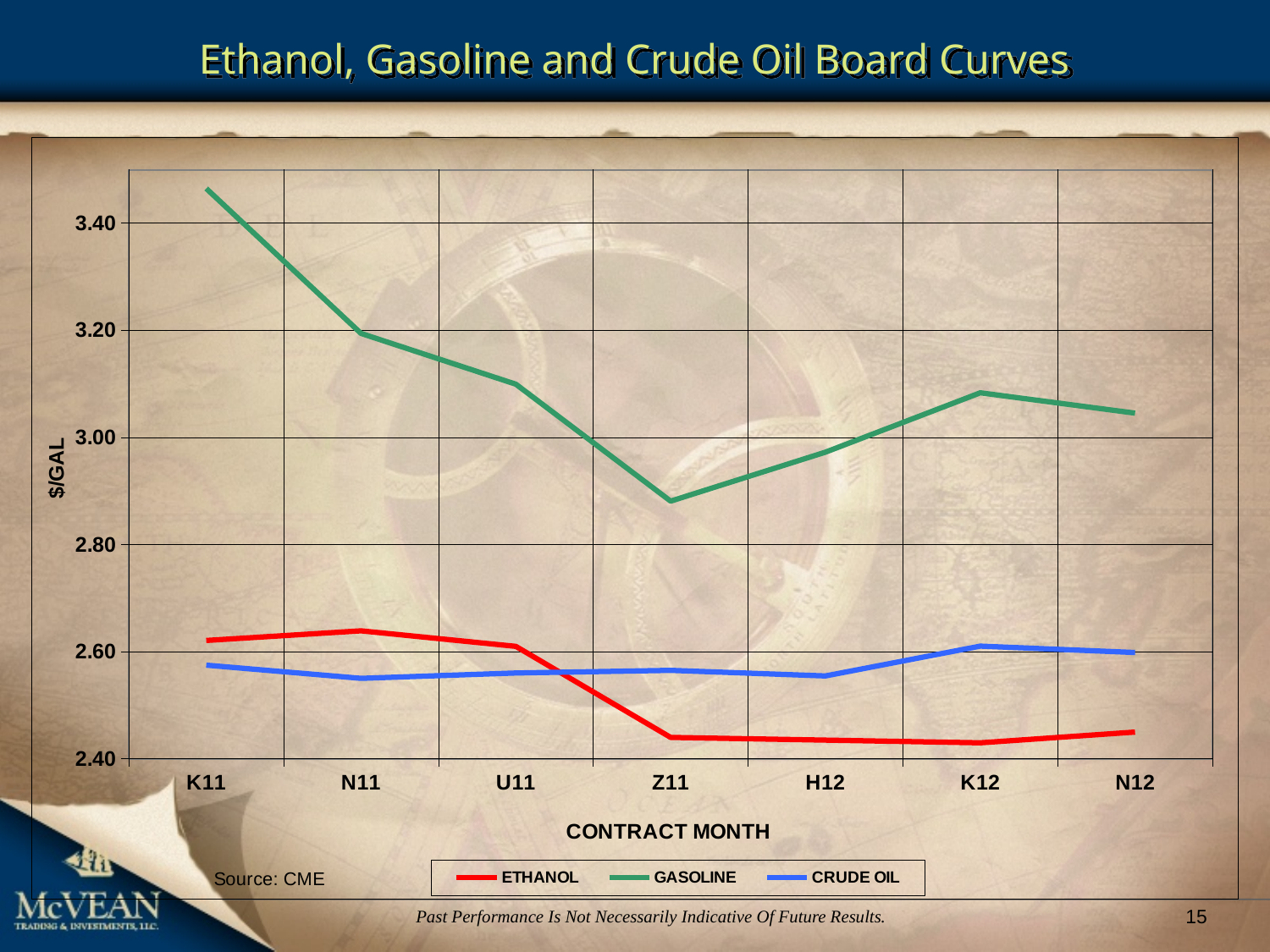
Is the GASOLINE value for Z11 greater or less than 3.00? less How many contract months are shown on the x axis? 7 At which contract month is the GASOLINE curve lowest? Z11 Is the CRUDE OIL value for K11 greater or less than 2.60? less What kind of chart is shown on the slide? line chart Does the GASOLINE curve rise or fall from K11 to Z11? fall How many series does the legend list? 3 What is the label on the vertical axis? $/GAL Is the ETHANOL value for Z11 greater or less than 2.60? less At Z11, which is larger: the ETHANOL value or the CRUDE OIL value? CRUDE OIL At which contract month is the GASOLINE curve highest? K11